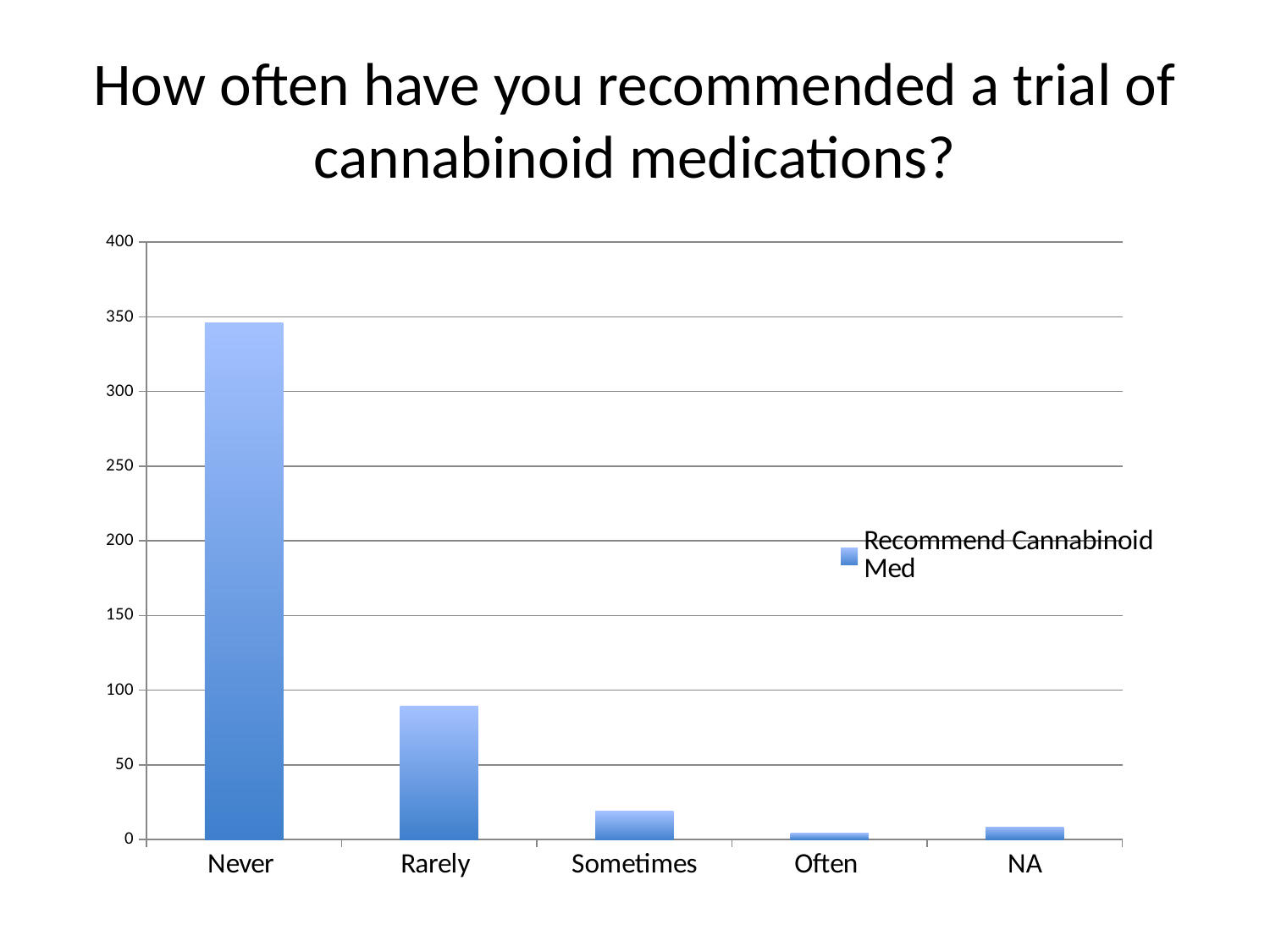
Which is larger, the value for Rarely or the value for Sometimes? Rarely Do the values rise or fall from Never to Often? fall Which is larger, the value for NA or the value for Often? NA How many categories are shown on the x axis? 5 Which category has the highest value? Never How many series does the legend list? 1 Is the value for Rarely greater or less than 50? greater Is the value for Never greater or less than 300? greater What kind of chart is shown? bar chart Which category has the lowest value? Often Is the value for Sometimes greater or less than 50? less